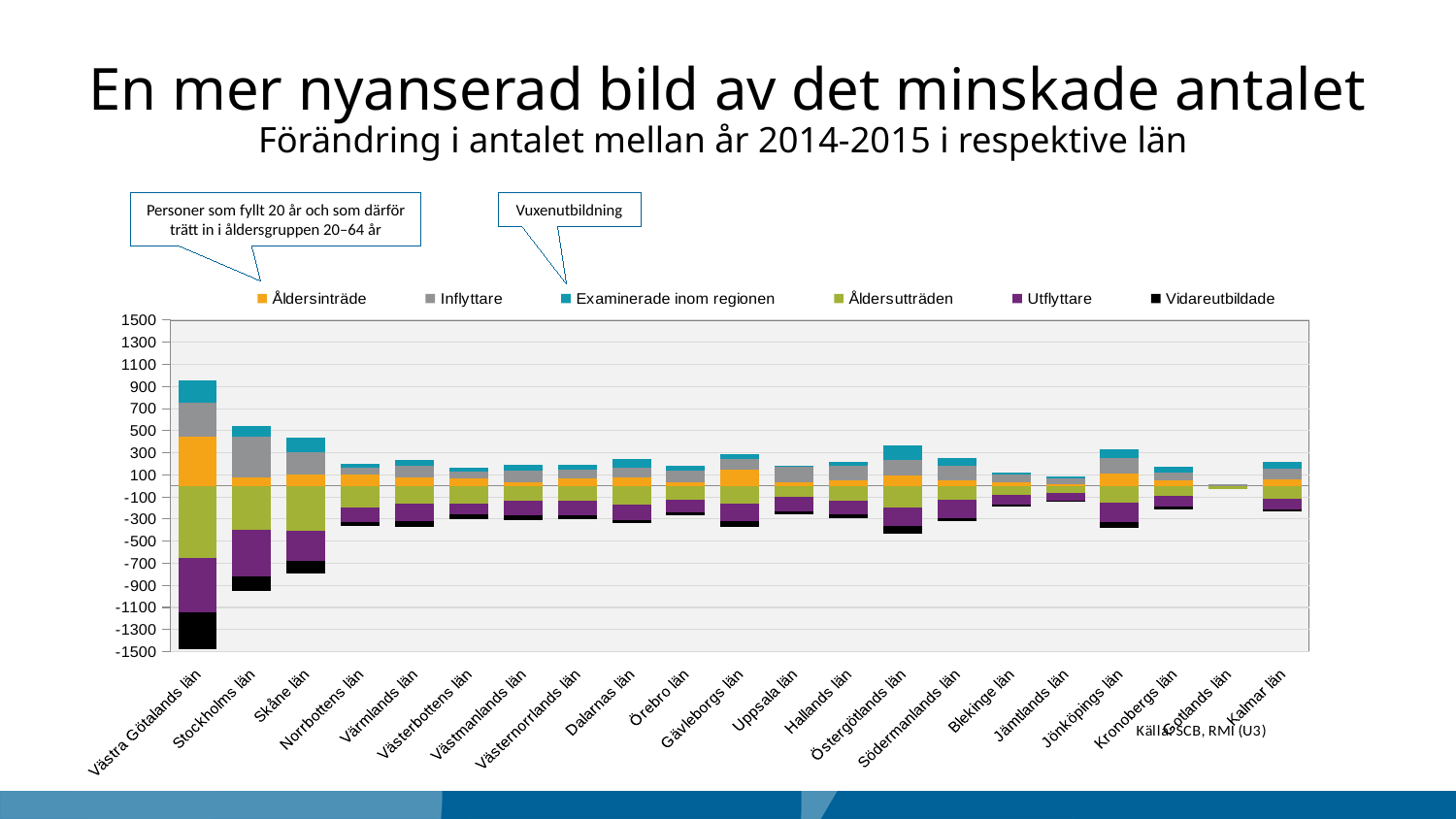
Is the bottom of the negative stack for Stockholms län greater or less than -700? less Which län has the negative stack that reaches furthest below zero? Västra Götalands län Is the top of the positive stack for Norrbottens län greater or less than 300? less Is the top of the positive stack for Skåne län greater or less than 500? less What is the subtitle of the chart on the slide? Förändring i antalet mellan år 2014-2015 i respektive län What kind of chart is shown on the slide? Stacked bar chart Which län has a taller positive stack, Stockholms län or Skåne län? Stockholms län How many series does the legend list? 6 Which legend entry is shown in orange? Åldersinträde How many län (categories) are shown along the x axis? 21 Which län has the smallest bars overall in the chart? Gotlands län Which län has the tallest positive stacked bar? Västra Götalands län